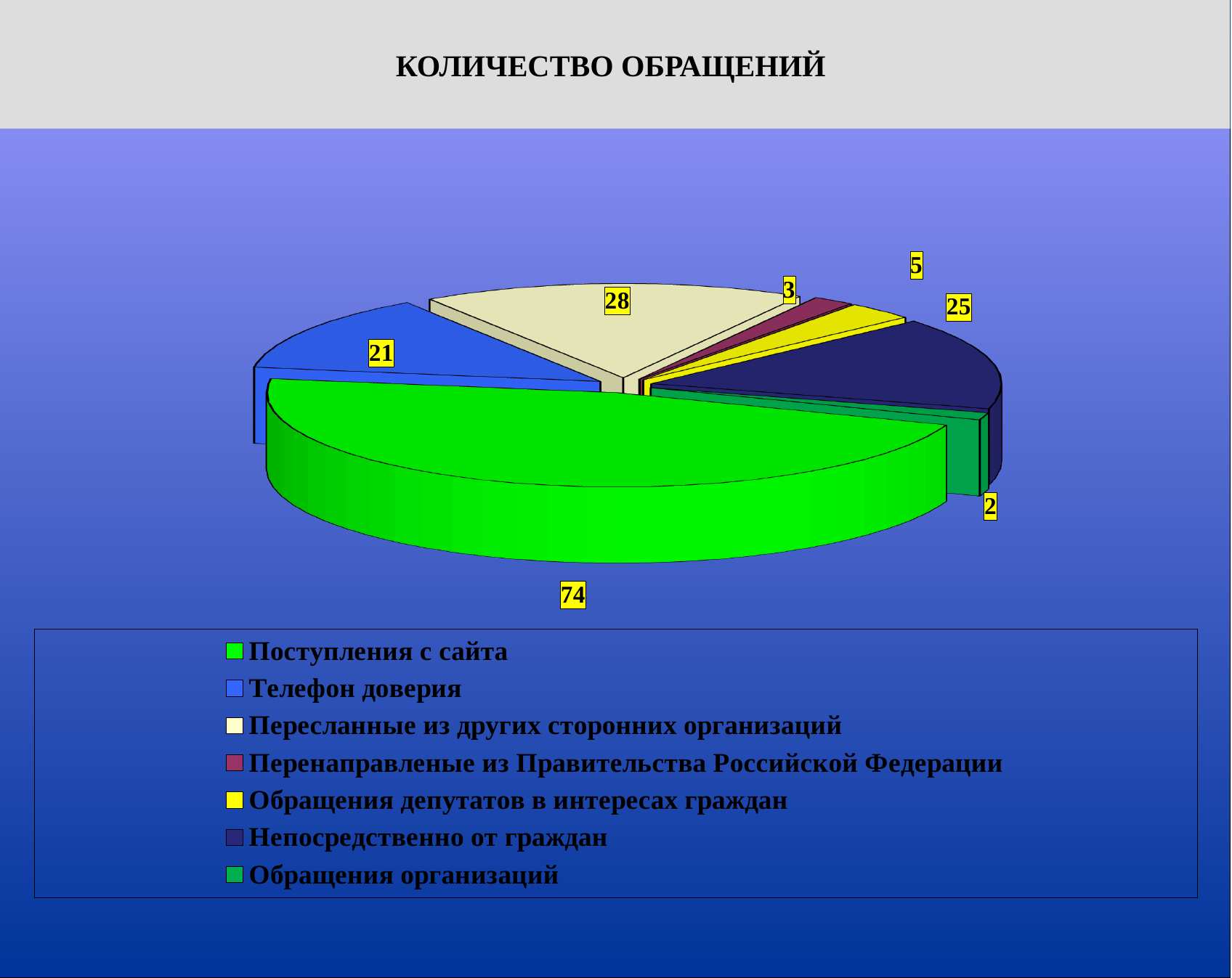
What is the title of the chart? КОЛИЧЕСТВО ОБРАЩЕНИЙ What is the value for Телефон доверия? 21 What type of chart is shown on the slide? Pie chart What is the value for Непосредственно от граждан? 25 How many categories does the pie chart have? 7 What is the value for Пересланные из других сторонних организаций? 28 What is the value for Поступления с сайта? 74 Which category has the lowest value? Обращения организаций Which category has the highest value? Поступления с сайта What is the value for Обращения депутатов в интересах граждан? 5 What is the difference between the values for Поступления с сайта and Пересланные из других сторонних организаций? 46 Which is larger: Телефон доверия or Непосредственно от граждан? Непосредственно от граждан